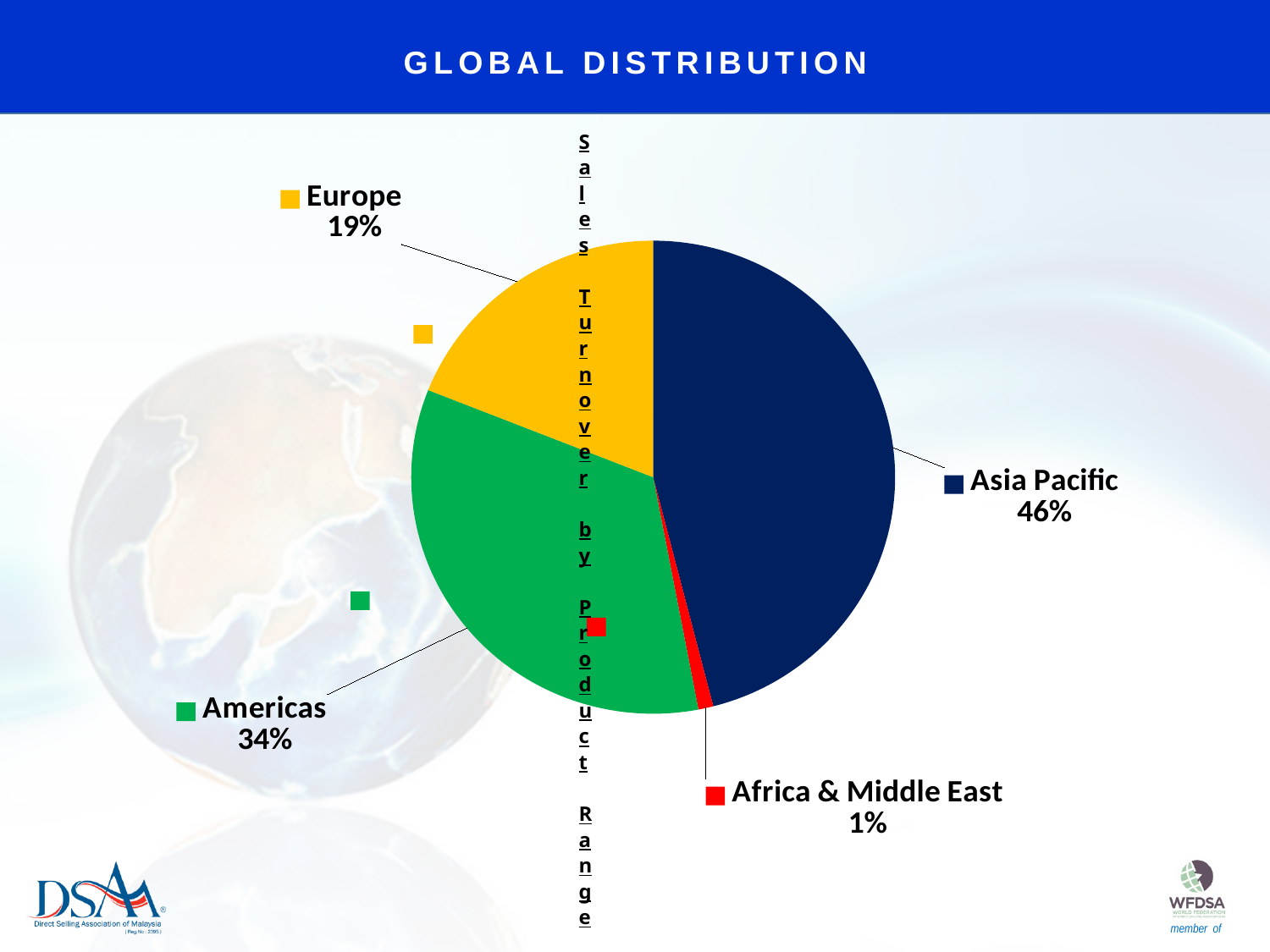
What is the title of the slide containing the pie chart? GLOBAL DISTRIBUTION How many slices does the pie chart have? 4 What is the difference in percentage points between Asia Pacific and Americas? 12 What share of the pie does Africa & Middle East have? 1% Which is larger, the share for Europe or the share for Americas? Americas Which region has the largest slice of the pie? Asia Pacific What share of the pie does Asia Pacific have? 46% What kind of chart is shown on the slide? pie chart What share of the pie does Europe have? 19% Which region has the smallest slice of the pie? Africa & Middle East What colour is the Asia Pacific slice? dark blue What share of the pie does Americas have? 34%